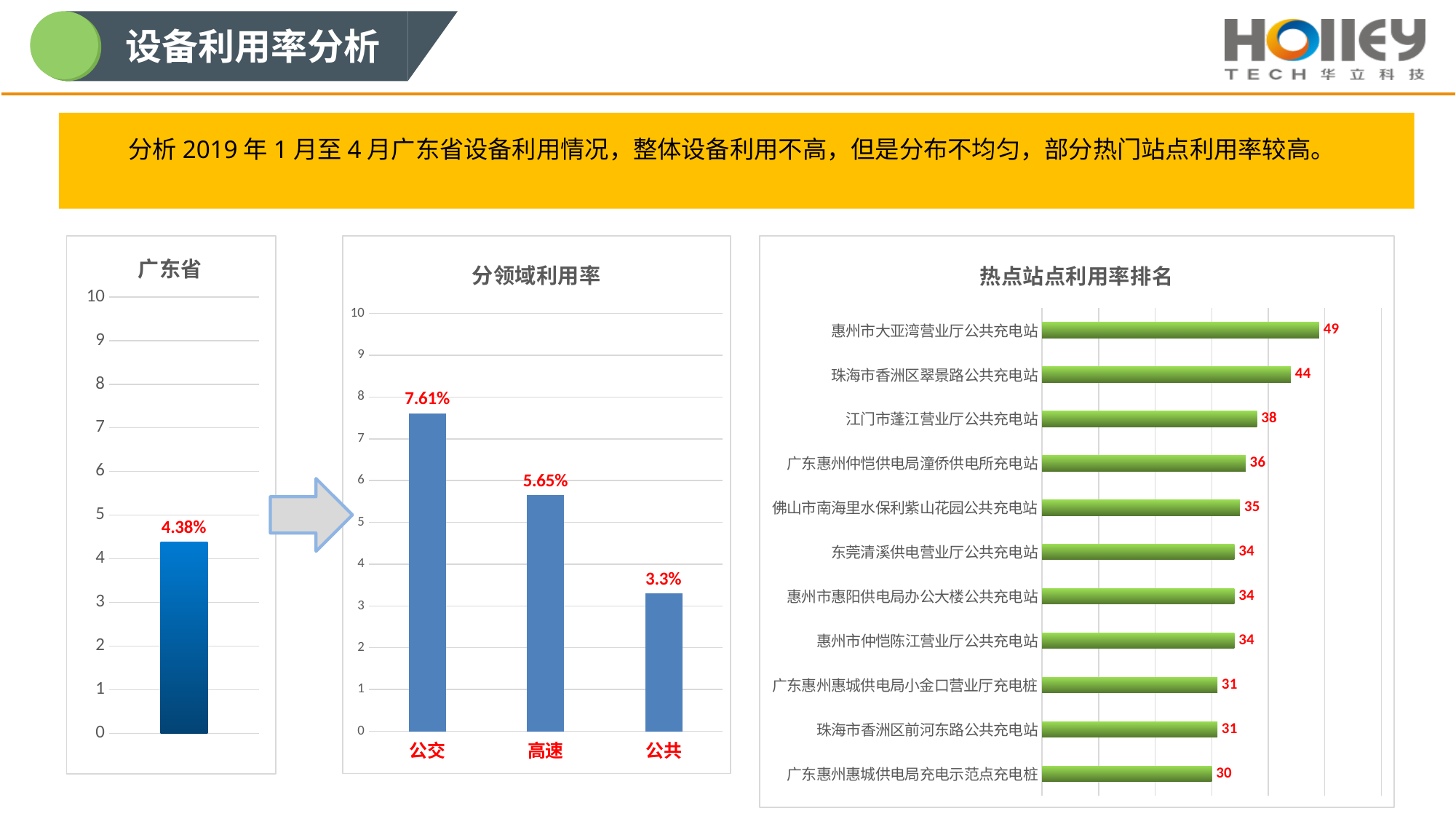
In the chart titled 分领域利用率, how many categories are shown on the x axis? 3 What kind of chart is the one titled 热点站点利用率排名? bar chart In the chart titled 热点站点利用率排名, what is the value for 惠州市大亚湾营业厅公共充电站? 49 In the chart titled 分领域利用率, which category has the highest value? 公交 In the chart titled 分领域利用率, which category has the lowest value? 公共 In the chart titled 广东省, what is the value shown on the bar? 4.38% In the chart titled 热点站点利用率排名, what is the difference between the values for 惠州市大亚湾营业厅公共充电站 and 珠海市香洲区翠景路公共充电站? 5 In the chart titled 分领域利用率, do the values rise or fall from 公交 to 公共 along the x axis? fall In the chart titled 热点站点利用率排名, what is the value for 江门市蓬江营业厅公共充电站? 38 In the chart titled 分领域利用率, what is the value for 公共? 3.3% In the chart titled 分领域利用率, what is the value for 公交? 7.61% In the chart titled 热点站点利用率排名, how many stations are listed? 11